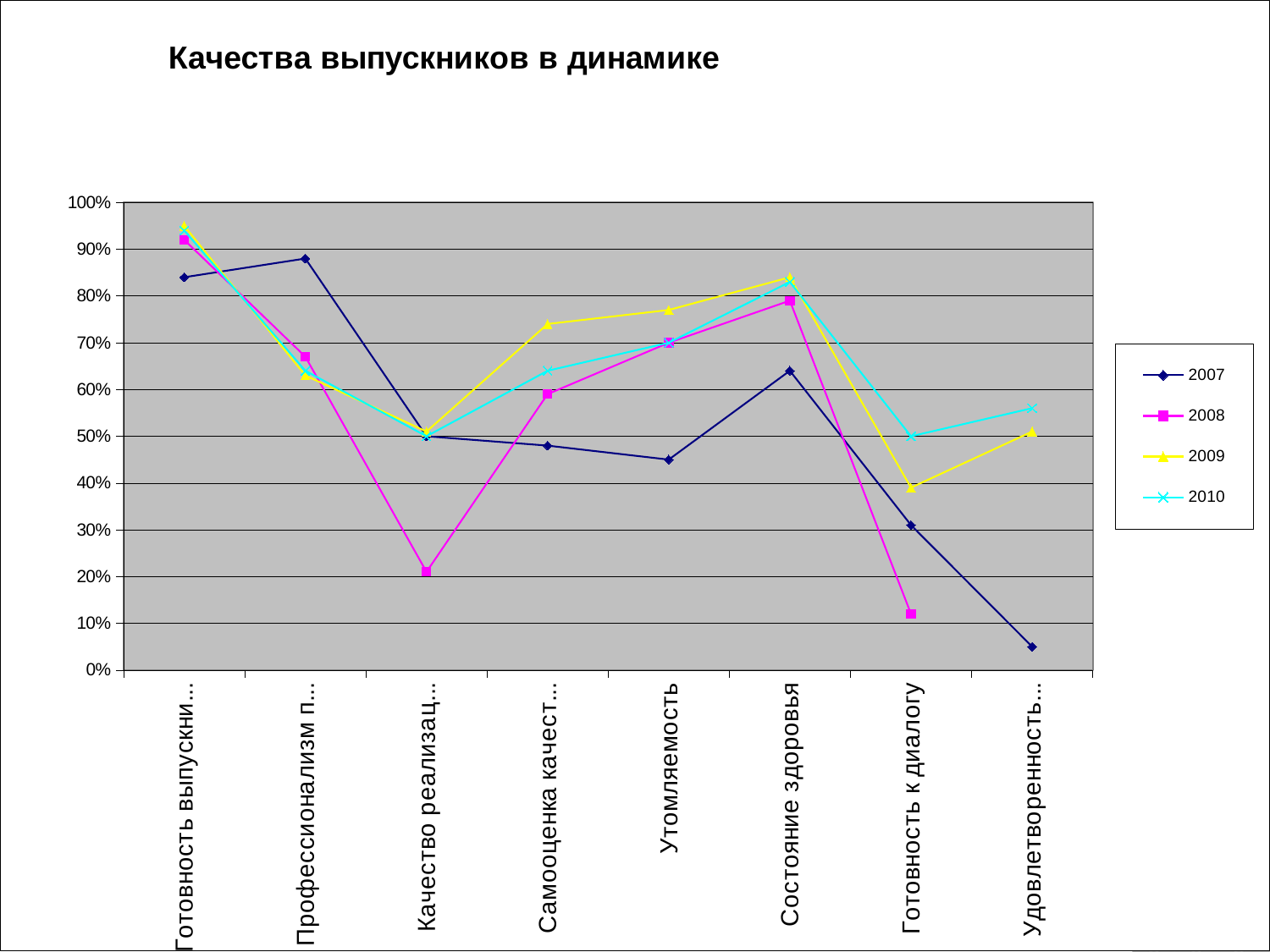
What kind of chart is shown on the slide? line chart Is the 2009 value for Состояние здоровья greater or less than 80%? greater Is the 2007 value for Утомляемость greater or less than 50%? less Does the 2007 line rise or fall from Состояние здоровья to Готовность к диалогу? fall Is the 2007 value for Готовность к диалогу greater or less than 40%? less Which category has the lowest value in the 2008 series? Готовность к диалогу How many categories are plotted along the x axis? 8 Which years are listed in the legend? 2007, 2008, 2009, 2010 How many series does the legend list? 4 For Утомляемость, which series has the larger value, 2007 or 2009? 2009 For Готовность к диалогу, which series has the larger value, 2009 or 2010? 2010